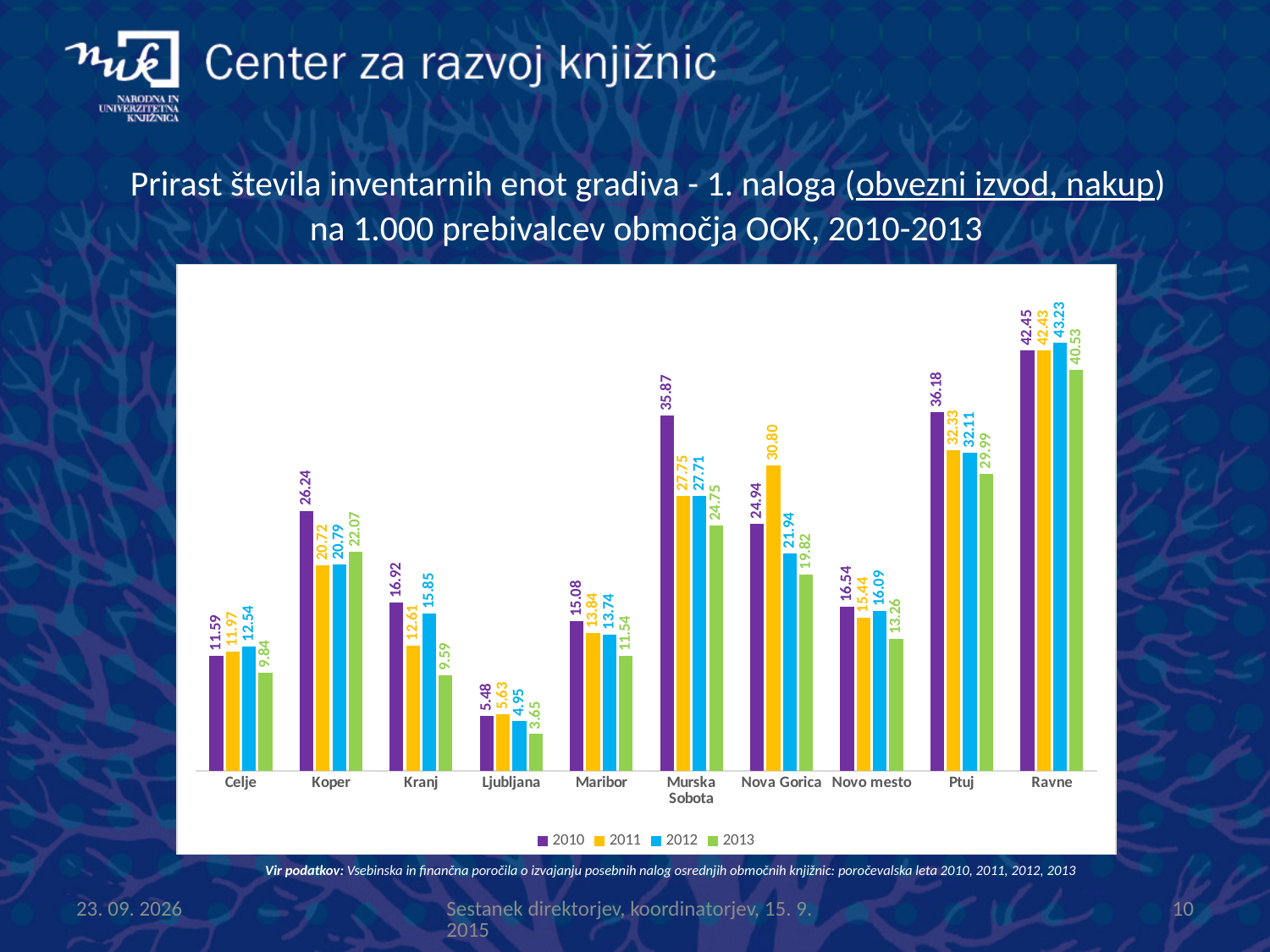
How many categories (libraries) are shown on the x axis? 10 Which category has the highest value for 2013? Ravne Do the values for Maribor rise or fall from 2010 to 2013? fall Which years are listed in the chart legend? 2010, 2011, 2012, 2013 Which category has the lowest value for 2010? Ljubljana What is the value for Murska Sobota in 2010? 35.87 What kind of chart is shown on the slide? bar chart What is the difference between the 2010 and 2013 values for Ptuj? 6.19 What is the value for Nova Gorica in 2011? 30.80 What is the value for Ljubljana in 2013? 3.65 For Nova Gorica, which is larger: the 2010 value or the 2011 value? 2011 How many series does the legend list? 4